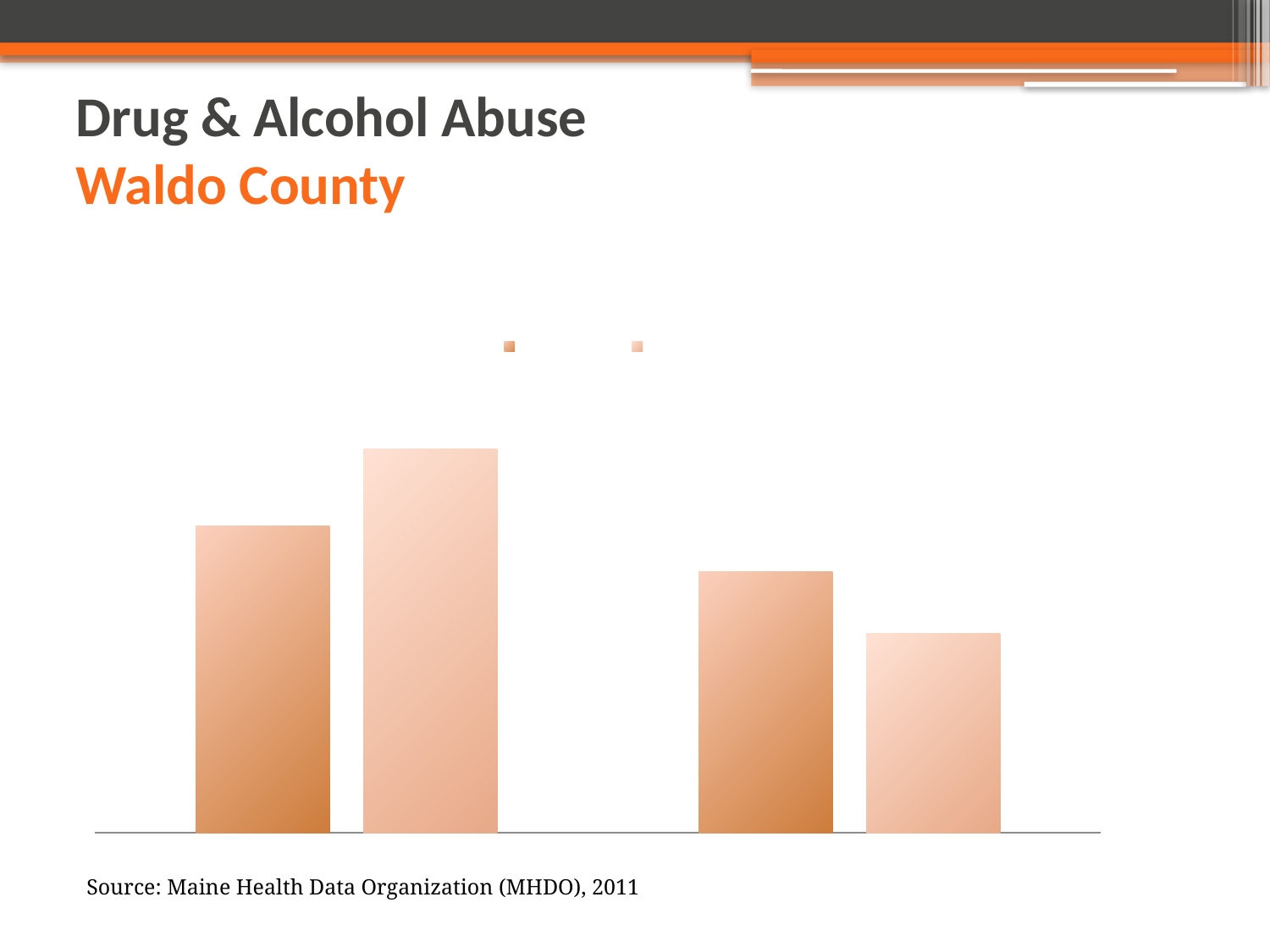
What kind of chart is shown on the slide? bar chart Which county does the slide title say the chart is about? Waldo County Into how many groups are the bars arranged? 2 Which bar is the tallest: the first, second, third or fourth from the left? second What source is cited below the chart? Maine Health Data Organization (MHDO), 2011 How many bars are plotted in the chart? 4 Is the second bar from the left taller or shorter than the first bar? taller Which bar is the shortest: the first, second, third or fourth from the left? fourth Is the third bar from the left taller or shorter than the fourth bar? taller How many series does the chart's legend show? 2 Is the first bar from the left taller or shorter than the third bar? taller